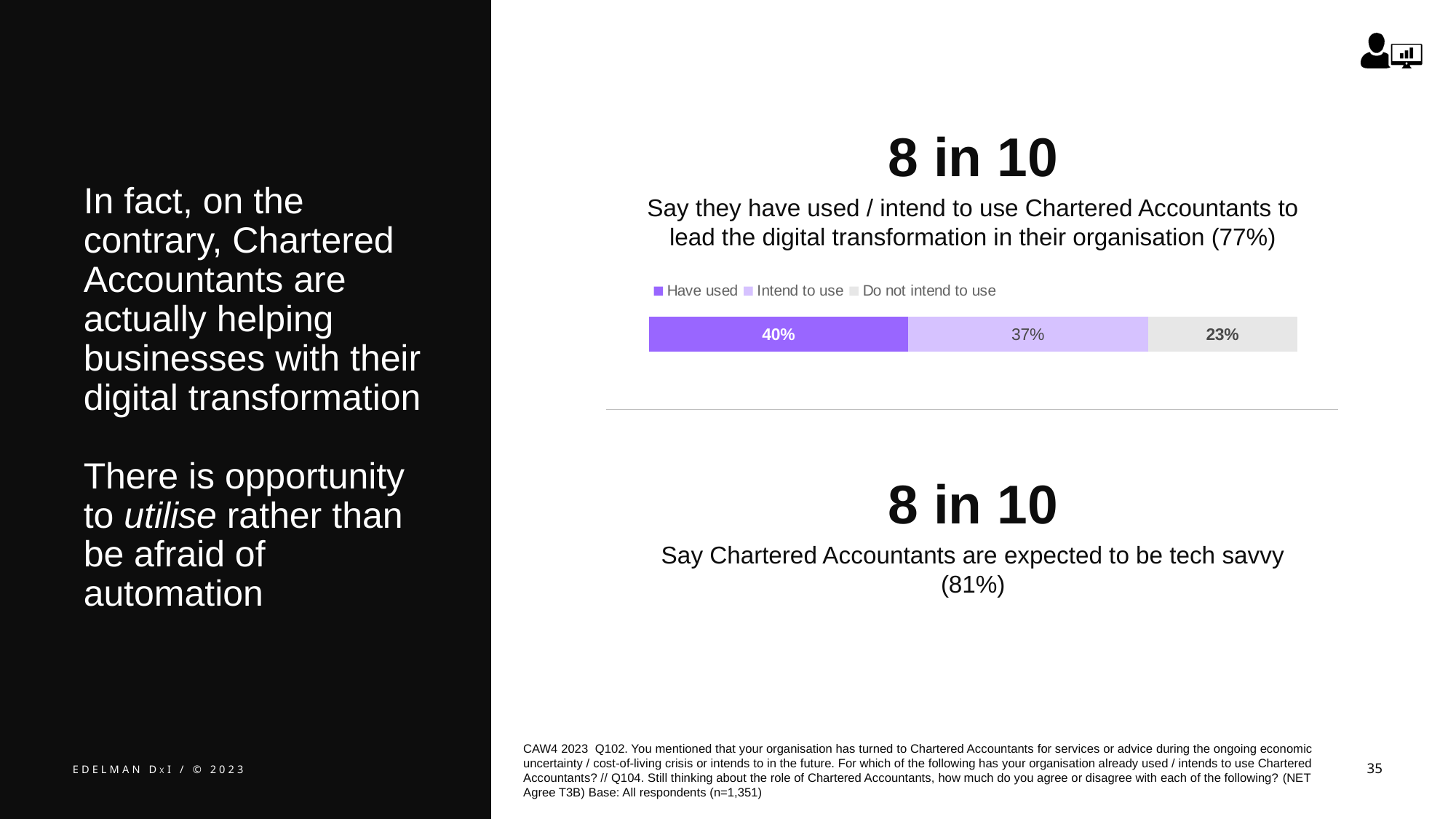
What is the combined percentage of 'Have used' and 'Intend to use'? 77% Which segment of the stacked bar is the largest? Have used What percentage of respondents intend to use Chartered Accountants to lead digital transformation? 37% What percentage of respondents say they have used Chartered Accountants to lead digital transformation? 40% What is the difference between the 'Have used' and 'Do not intend to use' percentages? 17% What kind of chart is shown on the slide? Stacked bar chart Which is larger, the 'Have used' share or the 'Intend to use' share? Have used Which segment of the stacked bar is the smallest? Do not intend to use Which legend entry is shown in the darkest purple colour? Have used What percentage of respondents do not intend to use Chartered Accountants to lead digital transformation? 23% How many series does the legend list? 3 What is the difference between the 'Intend to use' and 'Do not intend to use' percentages? 14%